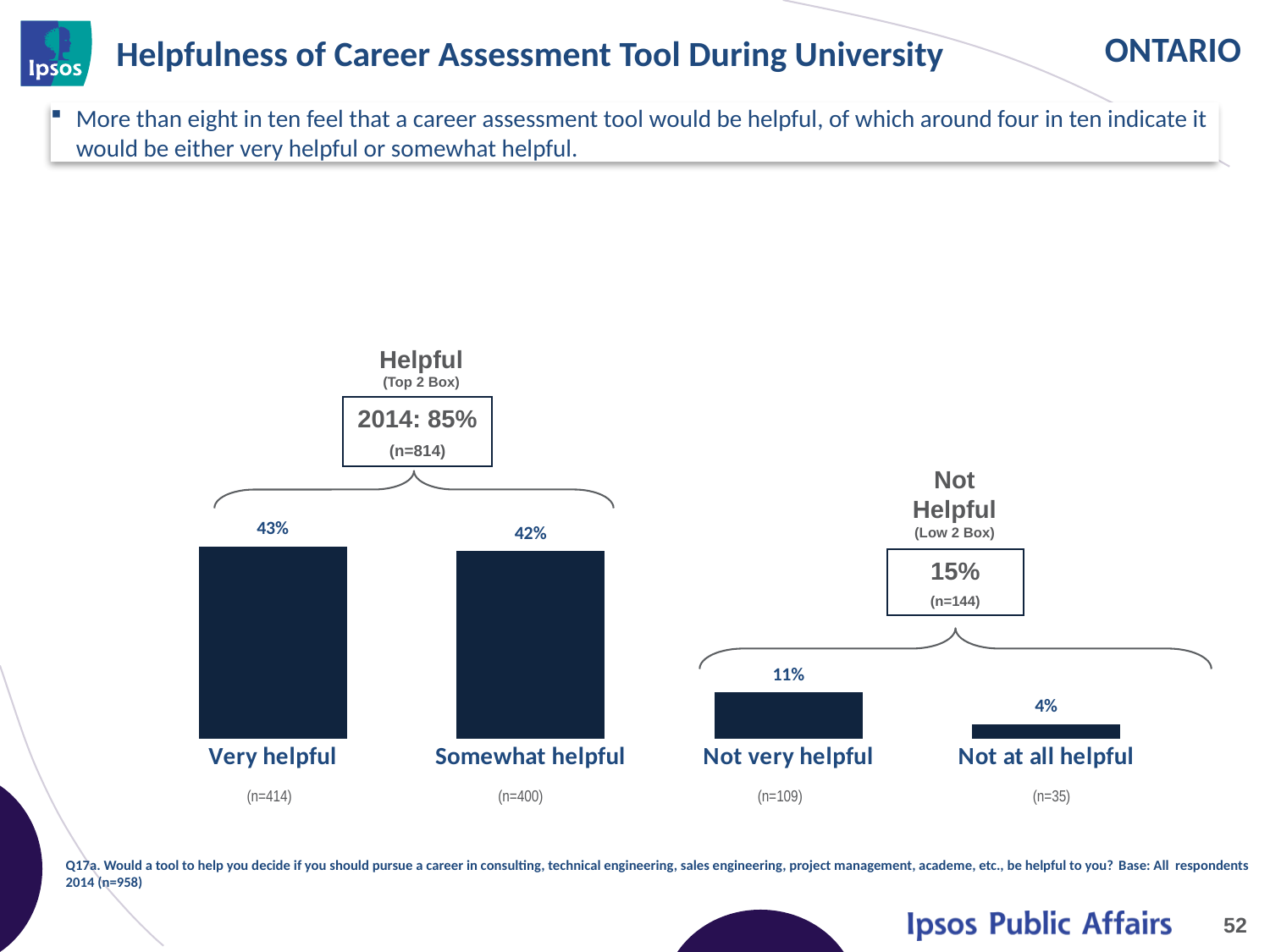
Which response category has the lowest percentage? Not at all helpful What type of chart is shown on the slide? Bar chart What is the difference in percentage points between 'Not very helpful' and 'Not at all helpful'? 7 What percentage of respondents said a career assessment tool would be somewhat helpful? 42% What percentage of respondents said a career assessment tool would be not very helpful? 11% What is the Low 2 Box 'Not Helpful' percentage shown? 15% Which is larger, the percentage for 'Somewhat helpful' or the percentage for 'Not very helpful'? Somewhat helpful How many response categories are shown in the chart? 4 Which response category has the highest percentage? Very helpful What percentage of respondents said a career assessment tool would be not at all helpful? 4% What is the Top 2 Box 'Helpful' percentage shown for 2014? 85% What percentage of respondents said a career assessment tool would be very helpful? 43%